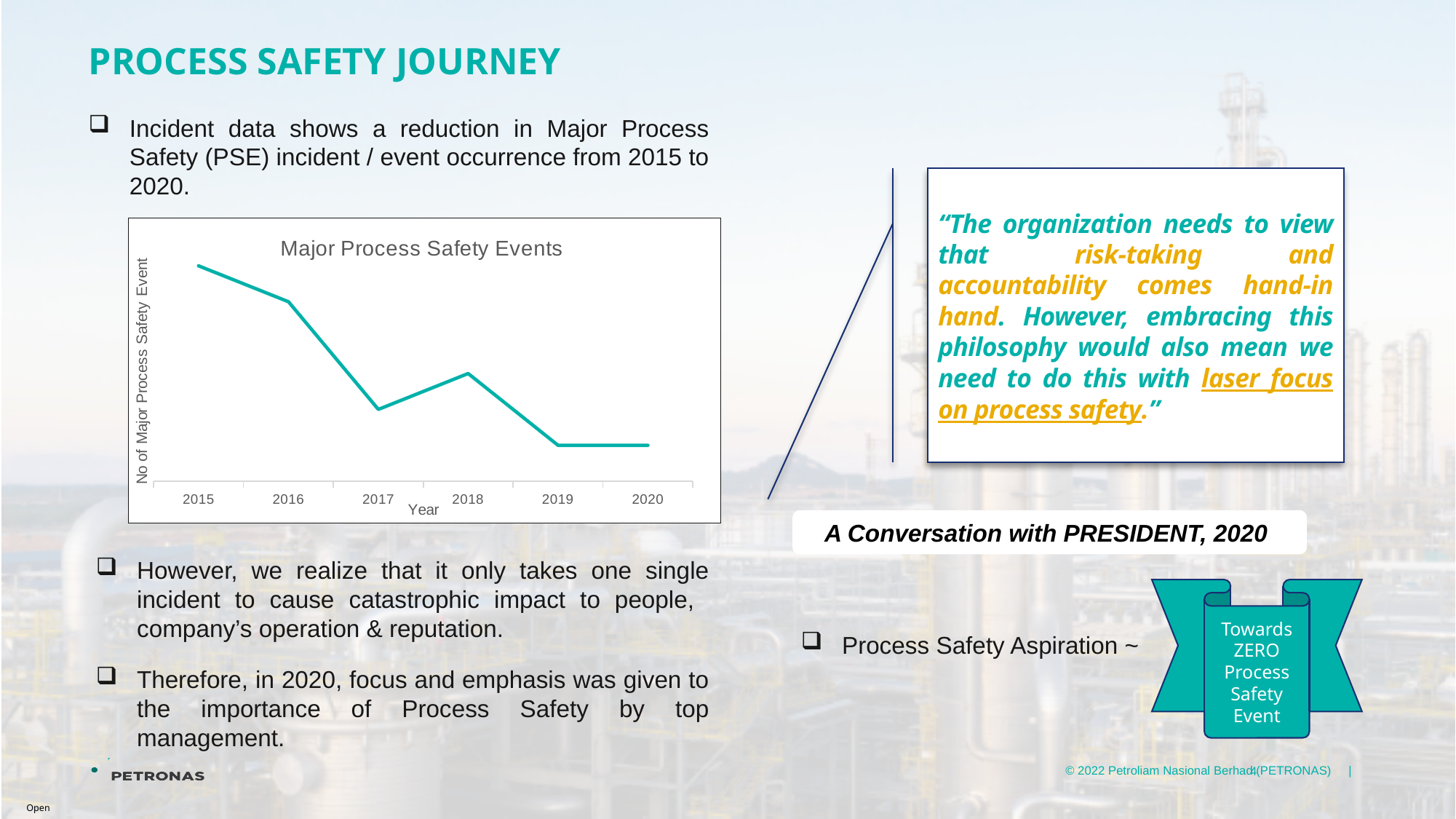
Between which two consecutive years does the line rise? 2017 to 2018 What is the label on the x axis of the chart? Year Is the value for 2019 higher or lower than the value for 2018? Lower What kind of chart is shown on the slide? Line chart Is the value for 2018 higher or lower than the value for 2016? Lower Is the value for 2016 higher or lower than the value for 2017? Higher How many years are plotted on the chart? 6 Which two years have the same, lowest value on the chart? 2019 and 2020 What is the title of the chart? Major Process Safety Events Which year has the highest number of Major Process Safety Events? 2015 Overall, do the values rise or fall from 2015 to 2020? Fall